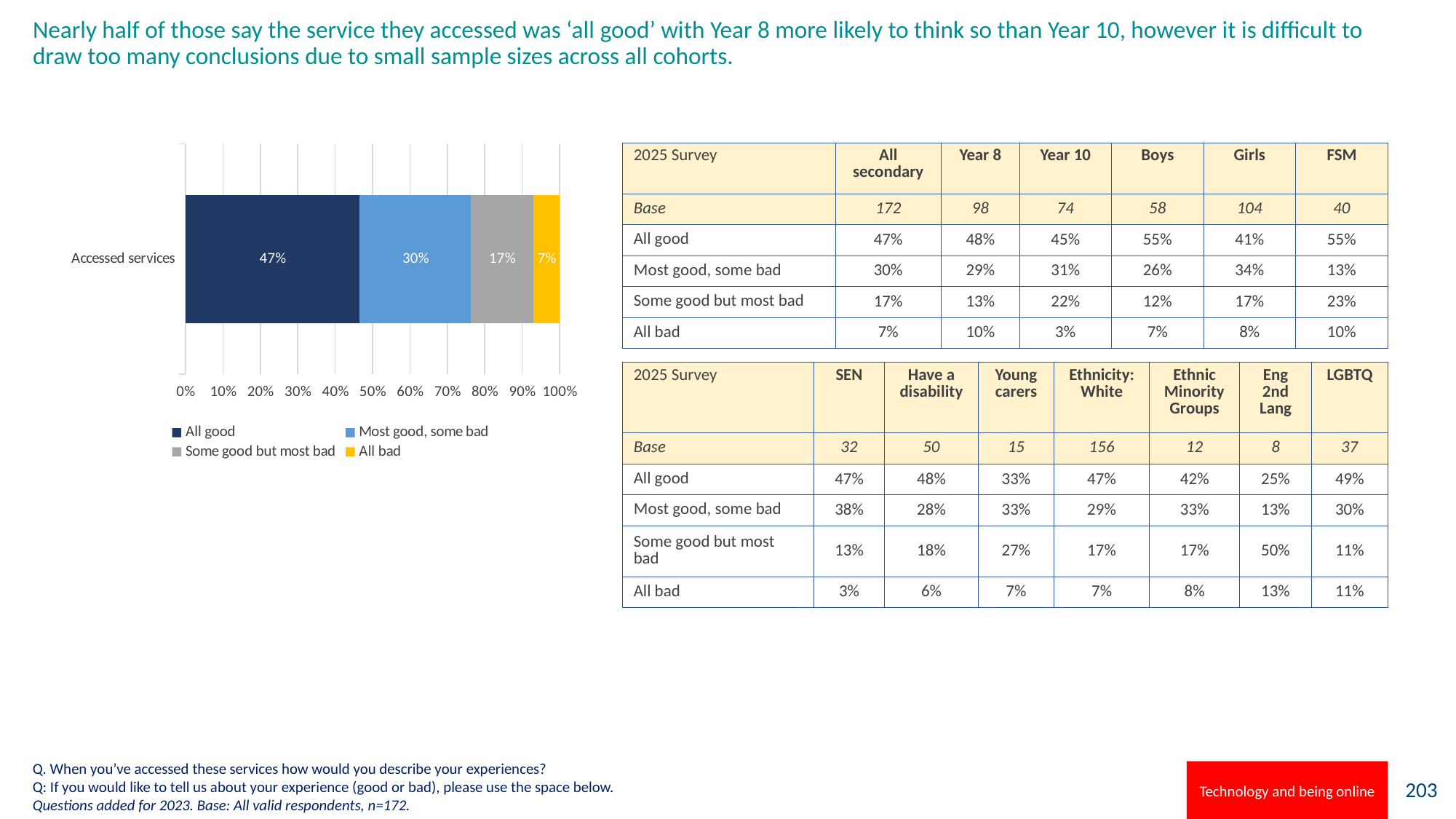
What is the difference in percentage points between 'All good' and 'Most good, some bad' in the chart? 17 What colour is the 'All bad' segment in the chart? Yellow Which response category has the smallest share of the 'Accessed services' bar? All bad Which response category has the largest share of the 'Accessed services' bar? All good How many series does the chart legend list? 4 What percentage of respondents who accessed services said 'All bad'? 7% What kind of chart is shown on the slide? Stacked bar chart What percentage of respondents who accessed services said 'Most good, some bad'? 30% What is the combined percentage of 'All good' and 'Most good, some bad' in the chart? 77% Which is larger in the chart: 'Some good but most bad' or 'All bad'? Some good but most bad What percentage of respondents who accessed services said 'Some good but most bad'? 17% What percentage of respondents who accessed services said the service was 'All good'? 47%